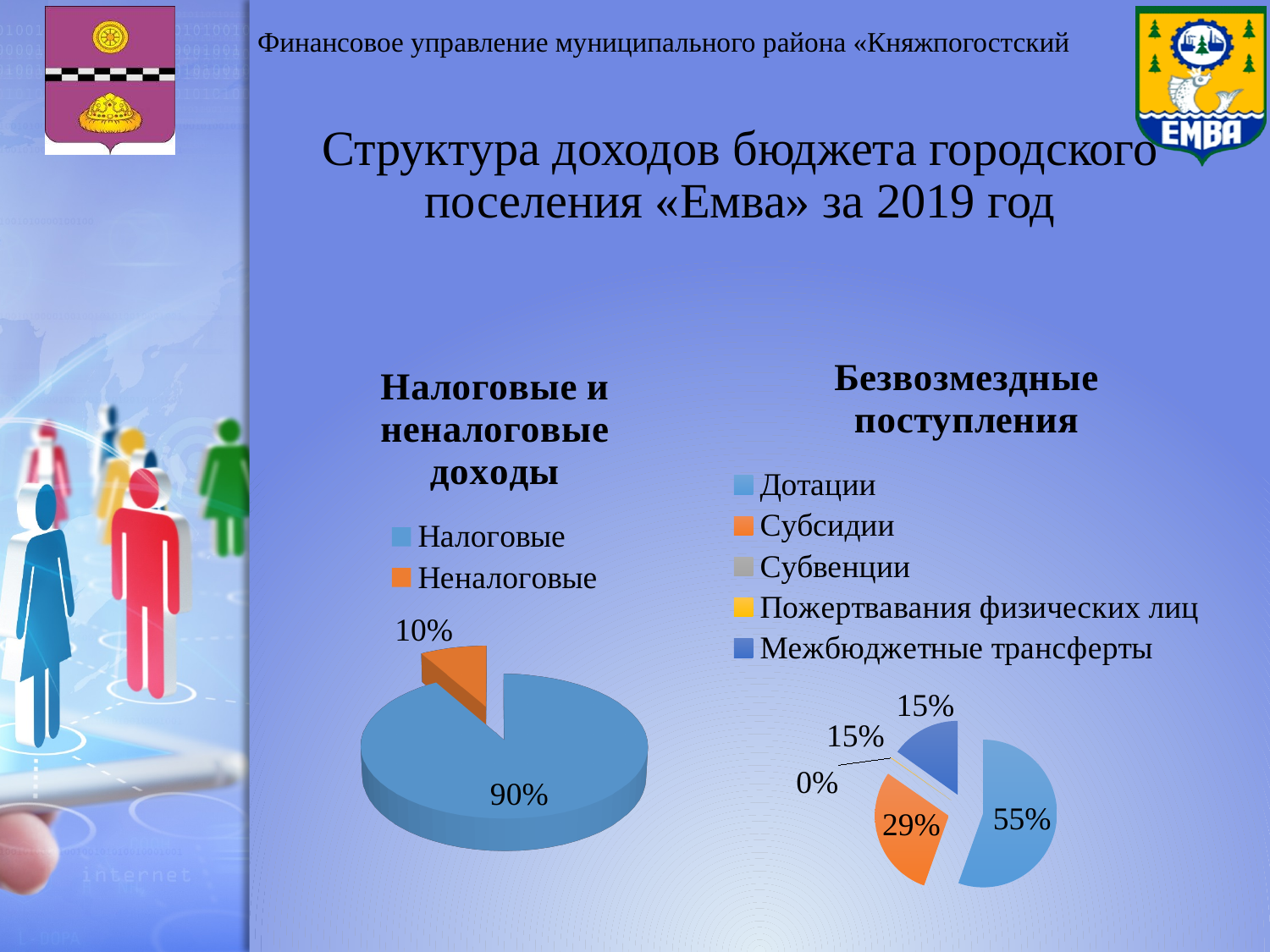
On the chart titled «Безвозмездные поступления», which category has the largest share? Дотации On the chart titled «Налоговые и неналоговые доходы», what share do Налоговые revenues make up? 90% On the chart titled «Налоговые и неналоговые доходы», what share do Неналоговые revenues make up? 10% What kind of chart is the one titled «Налоговые и неналоговые доходы»? Pie chart How many categories does the legend of the chart titled «Безвозмездные поступления» list? 5 On the chart titled «Налоговые и неналоговые доходы», which category has the larger share? Налоговые On the chart titled «Безвозмездные поступления», what share do Дотации make up? 55% How many categories does the legend of the chart titled «Налоговые и неналоговые доходы» list? 2 On the chart titled «Безвозмездные поступления», which is larger: Дотации or Субсидии? Дотации On the chart titled «Безвозмездные поступления», what is the difference in percentage points between Дотации and Субсидии? 26 percentage points On the chart titled «Налоговые и неналоговые доходы», what is the difference in percentage points between Налоговые and Неналоговые? 80 percentage points